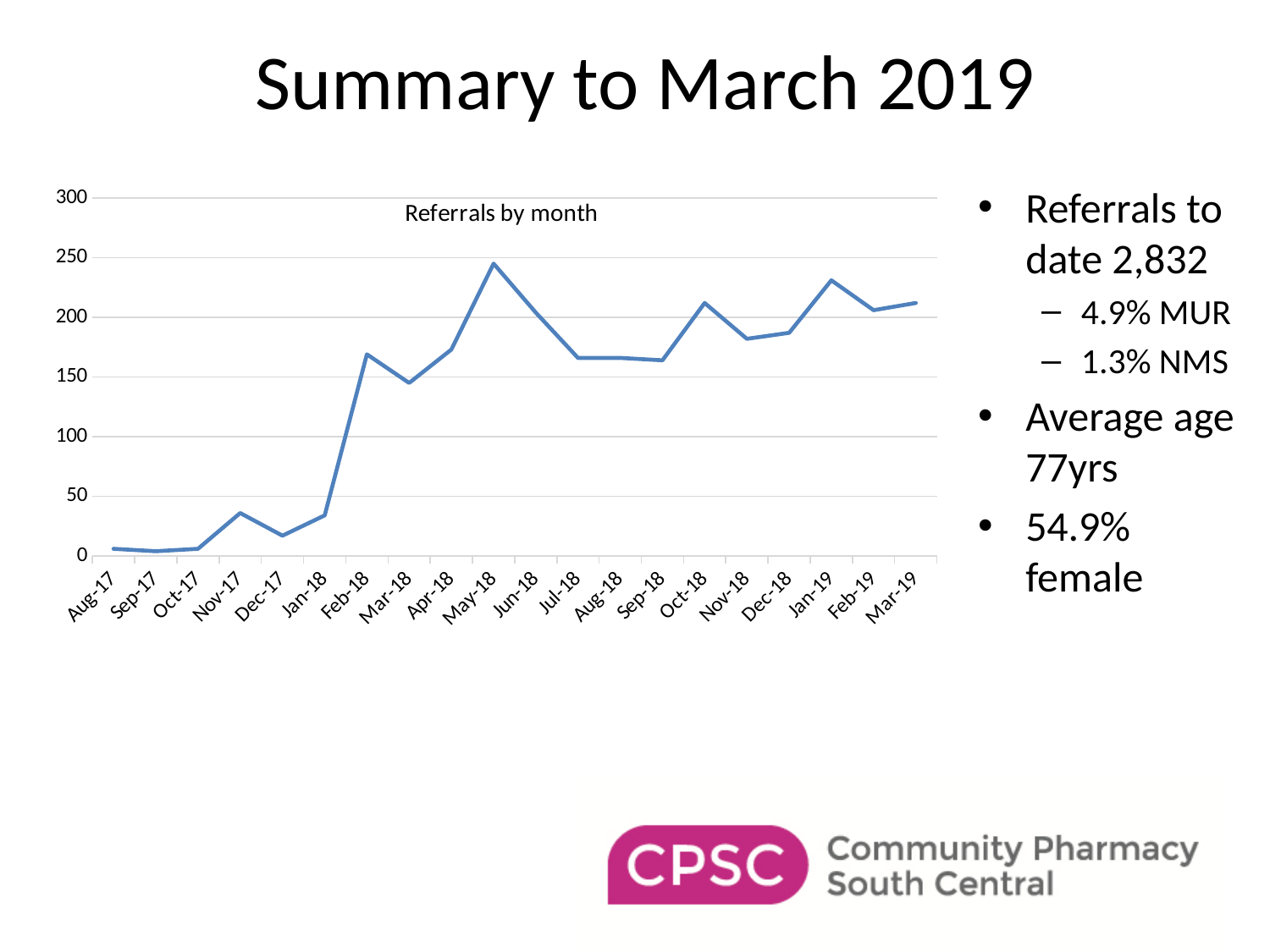
Is the value for Jul-18 greater or less than 200? less Is the value for May-18 greater or less than 200? greater What kind of chart is shown on the slide? line chart Which month has the highest number of referrals? May-18 Is the value for Feb-18 greater or less than 150? greater What is the title of the chart? Referrals by month Which month has more referrals, Mar-18 or May-18? May-18 How many months are plotted on the x axis of the chart? 20 Which month has more referrals, Jan-18 or Feb-18? Feb-18 Do referrals generally rise or fall from Aug-17 to Mar-19? rise